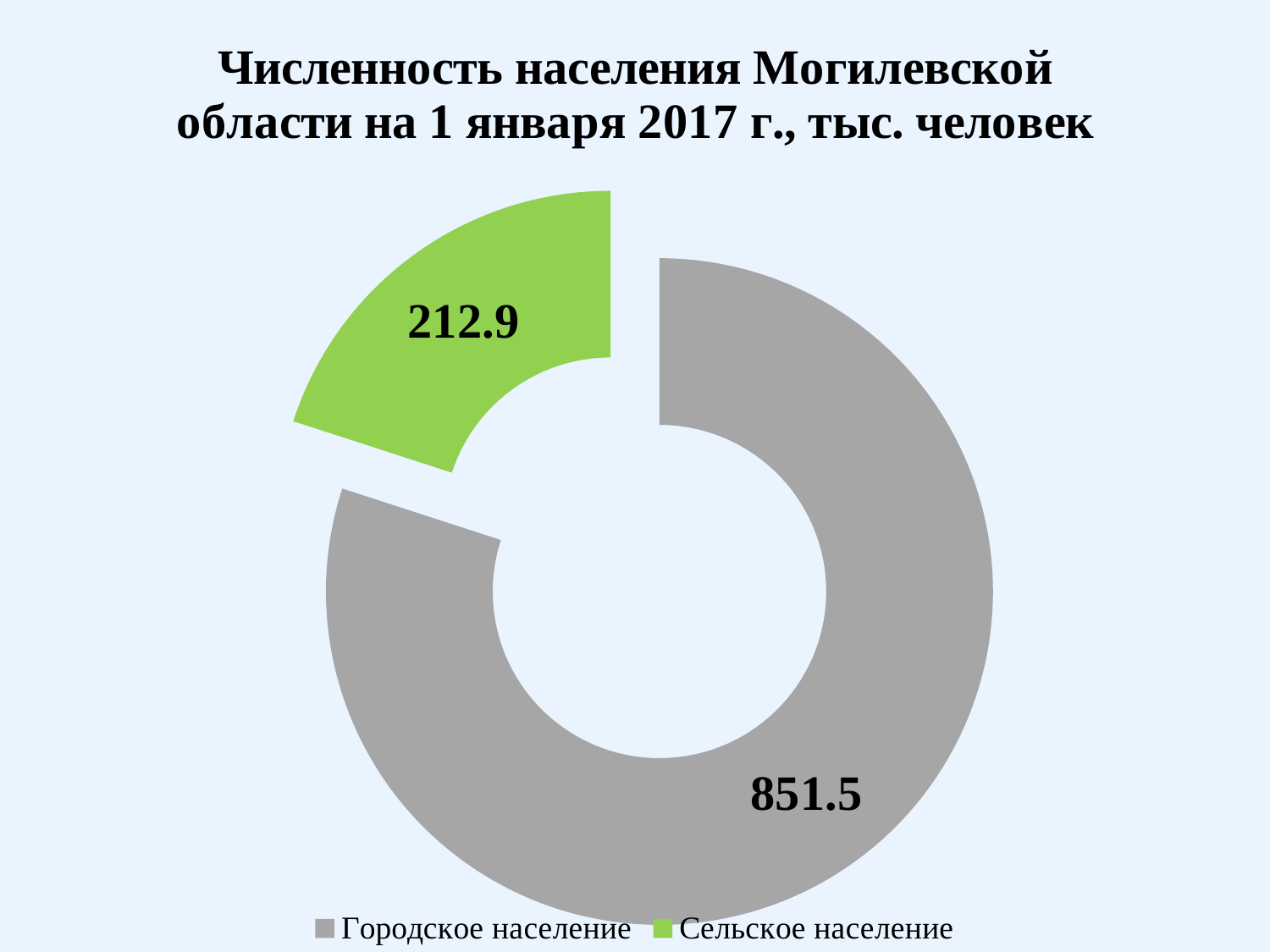
What is the difference between the values for Городское население and Сельское население? 638.6 Which is larger, Городское население or Сельское население? Городское население How many entries does the legend list? 2 What colour is the Сельское население slice? green How many categories does the chart show? 2 What kind of chart is shown on the slide? doughnut chart Which category has the largest value? Городское население Which category has the smallest value? Сельское население What is the total of the two values shown in the chart? 1064.4 What is the value for Сельское население? 212.9 What is the value for Городское население? 851.5 What share of the total does Сельское население represent? 20%